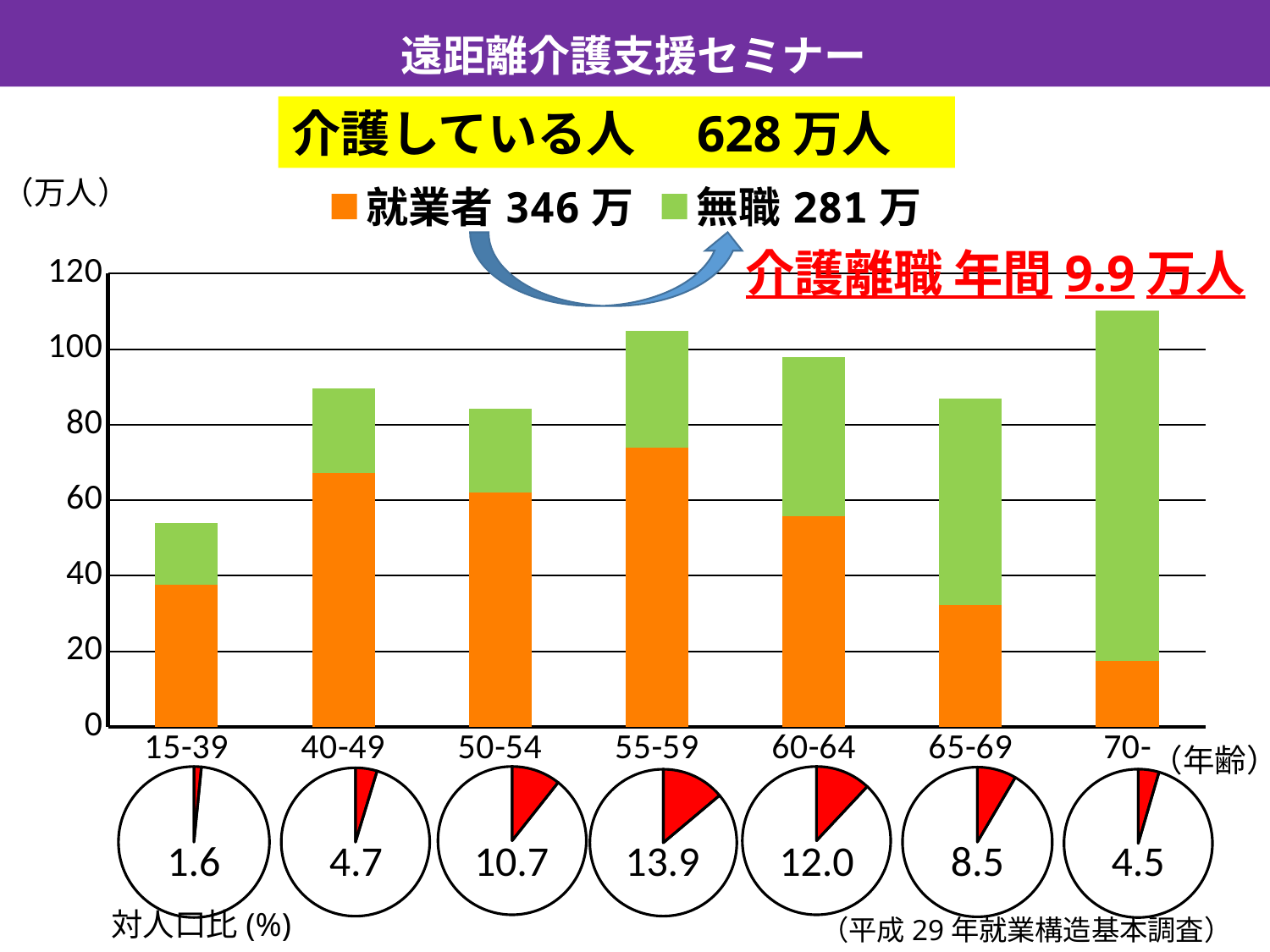
How many age categories are shown on the x axis of the bar chart? 7 In the circles below the bar chart, what is the 対人口比 (%) value for the 55-59 age group? 13.9 Which age group has the lowest total bar in the bar chart? 15-39 Is the total bar for the 55-59 age group greater or less than 100? greater Is the orange (就業者) segment for the 40-49 age group greater or less than 60? greater What is the difference between the 対人口比 (%) values for the 55-59 and 15-39 age groups? 12.3 Is the total bar for the 15-39 age group greater or less than 60? less In the circles below the bar chart, which age group has the lowest 対人口比 (%) value? 15-39 How many series does the legend of the bar chart list? 2 What kind of chart is the main chart on the slide? stacked bar chart Which age group has the tallest orange (就業者) segment in the bar chart? 55-59 Which age group has the tallest green (無職) segment in the bar chart? 70-